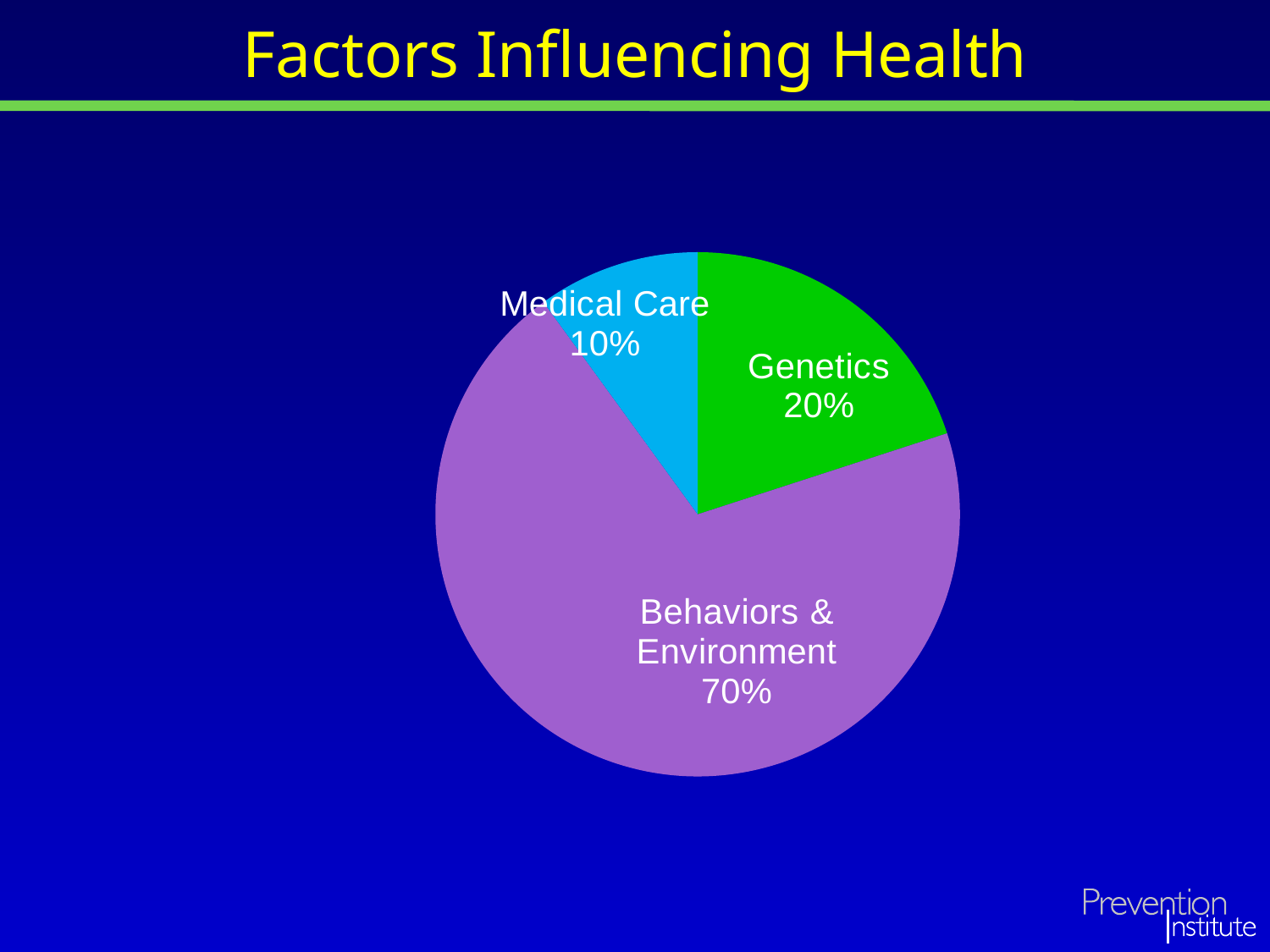
What is the difference in percentage points between Behaviors & Environment and Genetics? 50 What share of the pie is labelled Genetics? 20% How many slices does the pie chart have? 3 What is the difference in percentage points between Genetics and Medical Care? 10 What colour is the Genetics slice of the pie? green What share of the pie is labelled Behaviors & Environment? 70% Which slice of the pie is the largest? Behaviors & Environment Which slice of the pie is the smallest? Medical Care Which is larger, the Genetics slice or the Medical Care slice? Genetics What share of the pie is labelled Medical Care? 10% What kind of chart is shown on the slide? pie chart What is the title of the slide containing the pie chart? Factors Influencing Health